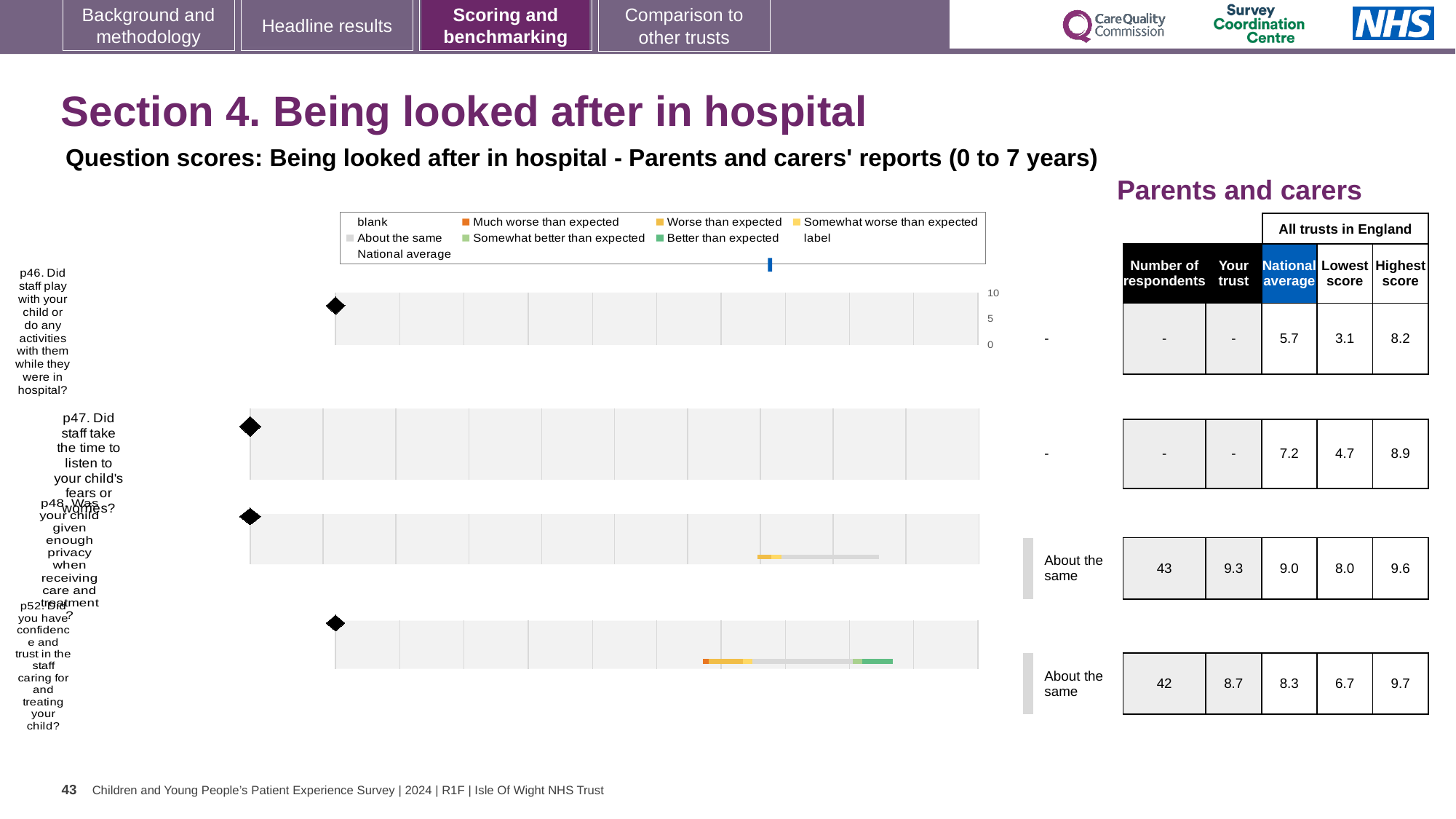
What is the lowest score across all trusts in England for p46 (Did staff play with your child or do any activities with them while they were in hospital?)? 3.1 What is the 'Your trust' score for p52 (Did you have confidence and trust in the staff caring for and treating your child?)? 8.7 Which question has the lowest national average score? p46 What is the national average score for p48 (Was your child given enough privacy when receiving care and treatment?)? 9.0 How many respondents are listed for p48? 43 What kind of chart is used to show the question scores on this slide? Bar chart How many survey questions (categories) are plotted in the chart? 4 What is the highest score across all trusts in England for p47 (Did staff take the time to listen to your child's fears or worries?)? 8.9 For p52, which is larger: the 'Your trust' score or the national average? Your trust For p48, what is the difference between the 'Your trust' score and the national average? 0.3 Which question has the highest national average score? p48 What is the highest value shown on the chart's score axis? 10